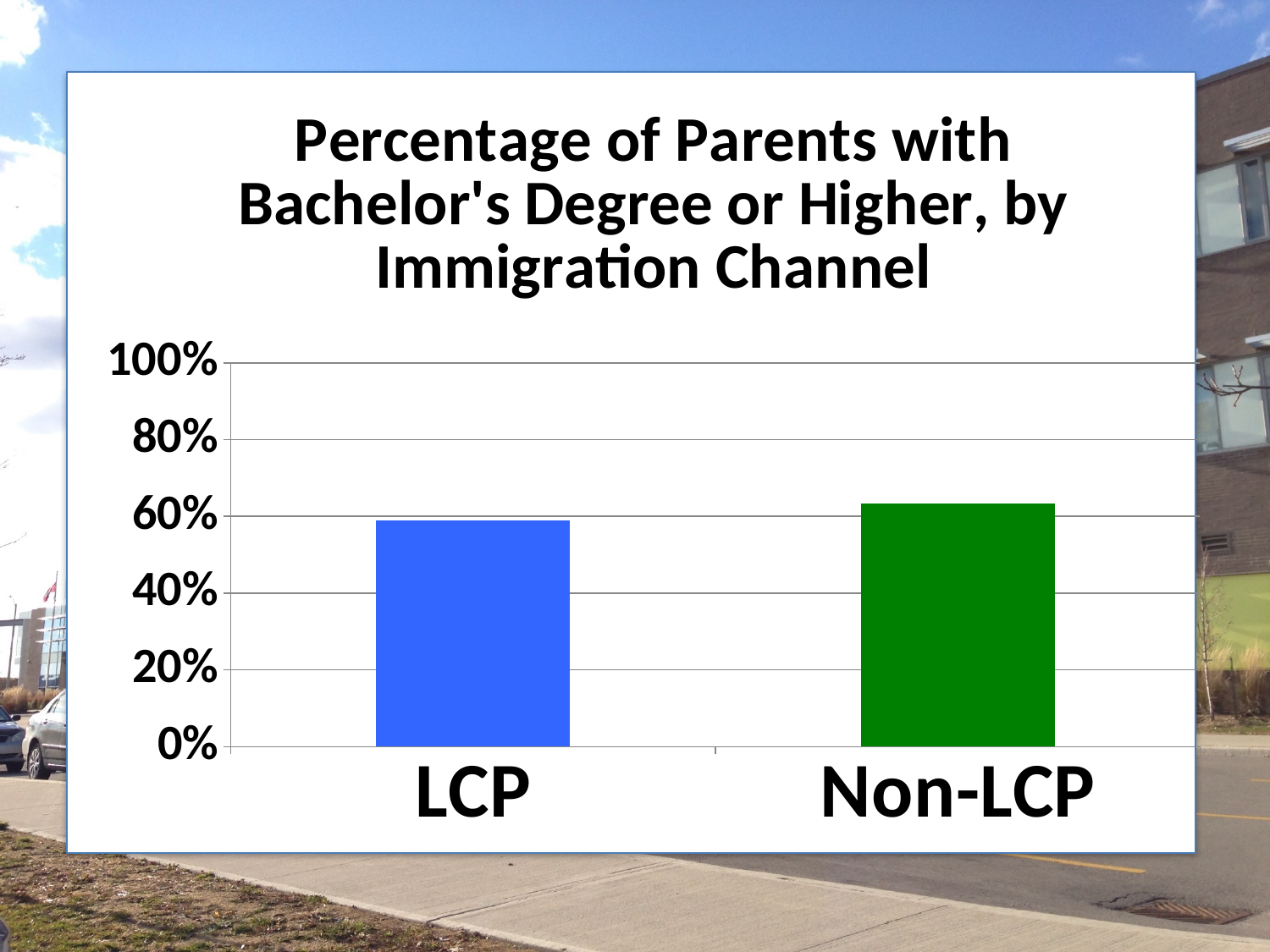
What is the highest value shown on the y axis? 100% Which category has the higher percentage of parents with a bachelor's degree or higher? Non-LCP Is the value for LCP greater or less than 40%? greater Is the value for LCP larger or smaller than the value for Non-LCP? smaller Is the value for LCP greater or less than 80%? less What kind of chart is shown on the slide? bar chart Is the value for Non-LCP greater or less than 40%? greater What is the title of the chart? Percentage of Parents with Bachelor's Degree or Higher, by Immigration Channel Which category has the lower percentage of parents with a bachelor's degree or higher? LCP How many categories are plotted on the x axis? 2